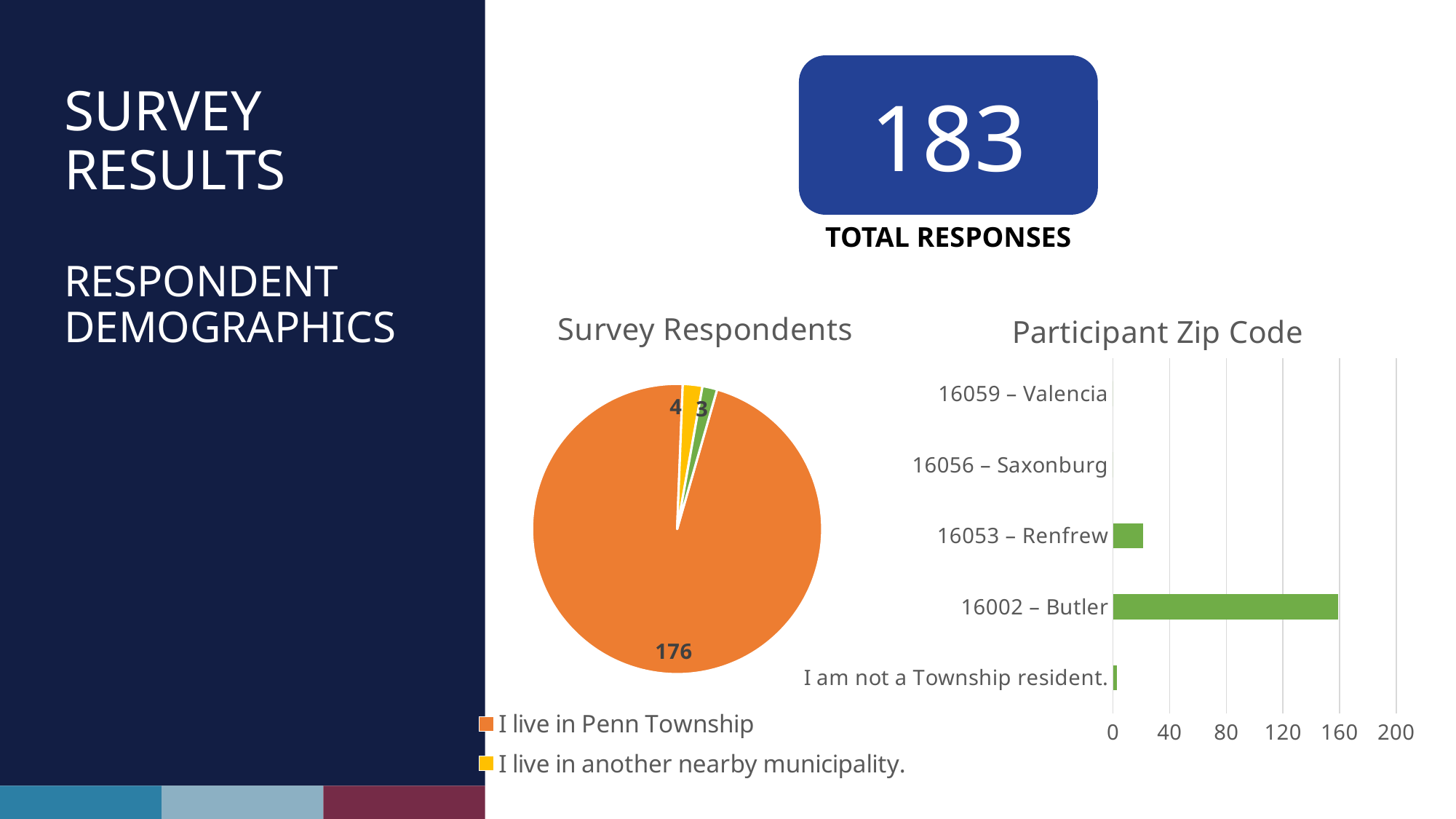
In the Participant Zip Code chart, which category has the highest value? 16002 – Butler In the Participant Zip Code chart, is the value for 16053 – Renfrew greater or less than 40? less What kind of chart is the Participant Zip Code chart? bar chart In the Participant Zip Code chart, which is larger: 16053 – Renfrew or 16002 – Butler? 16002 – Butler In the Survey Respondents pie chart, what is the difference between the "I live in Penn Township" slice and the "I live in another nearby municipality." slice? 172 In the Survey Respondents pie chart, which category has the largest slice? I live in Penn Township In the Participant Zip Code chart, is the value for 16002 – Butler greater or less than 120? greater How many categories are shown on the Participant Zip Code chart? 5 In the Survey Respondents pie chart, how many respondents said "I live in another nearby municipality."? 4 In the Survey Respondents pie chart, how many respondents said "I live in Penn Township"? 176 How many entries does the legend of the Survey Respondents chart list? 2 What kind of chart is the Survey Respondents chart? pie chart